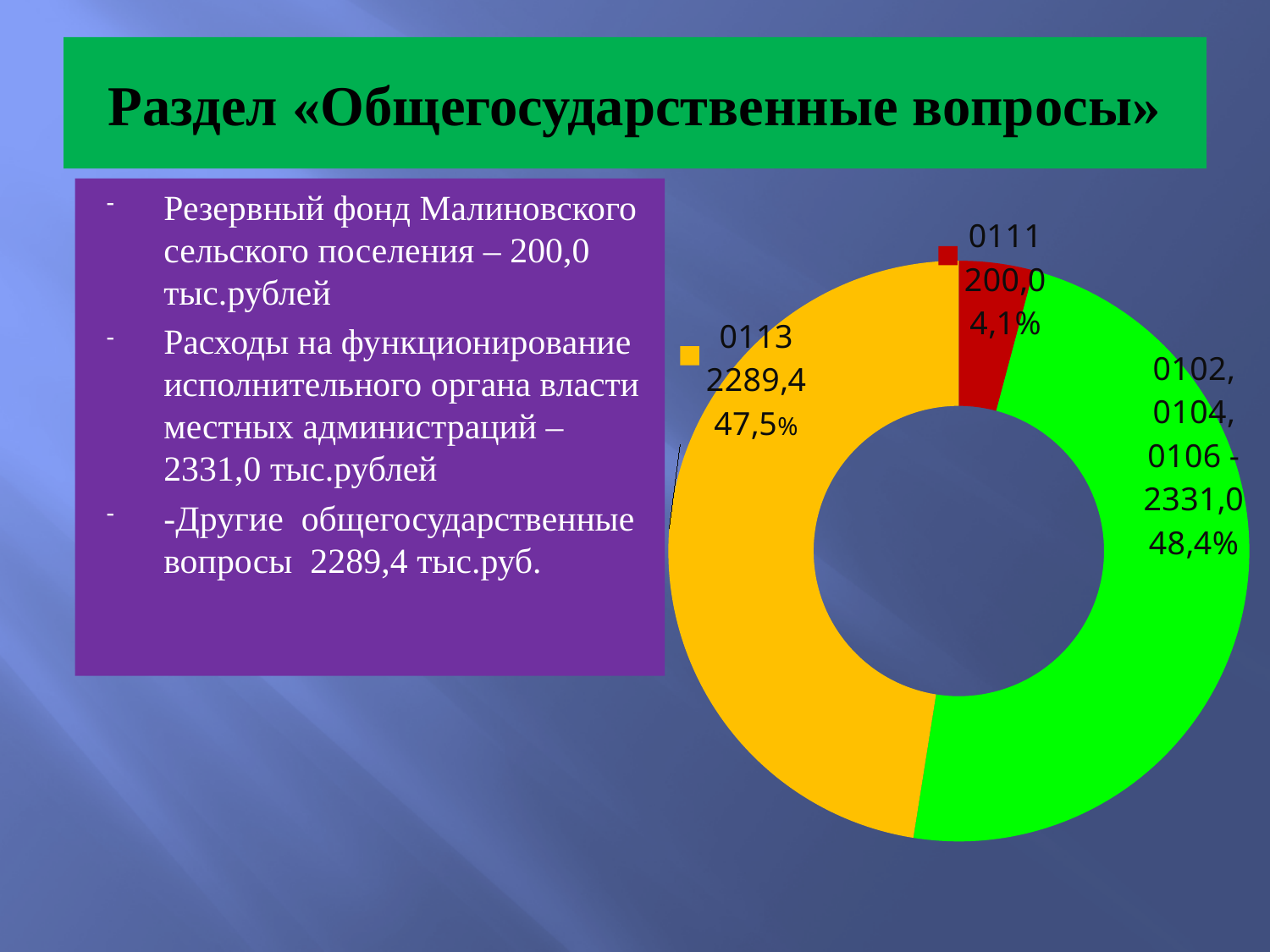
What share of the pie does the slice labelled 0102, 0104, 0106 represent? 48,4% What is the value shown for the slice labelled 0102, 0104, 0106? 2331,0 What share of the pie does slice 0113 represent? 47,5% Which slice has the smallest value? 0111 What is the value shown for slice 0113? 2289,4 What share of the pie does slice 0111 represent? 4,1% How many slices does the pie chart have? 3 What is the value shown for slice 0111? 200,0 What colour is the slice for 0111? dark red What kind of chart is shown on the slide? doughnut chart What is the difference between the value for 0113 and the value for 0111? 2089,4 What is the difference between the value for 0102, 0104, 0106 and the value for 0111? 2131,0